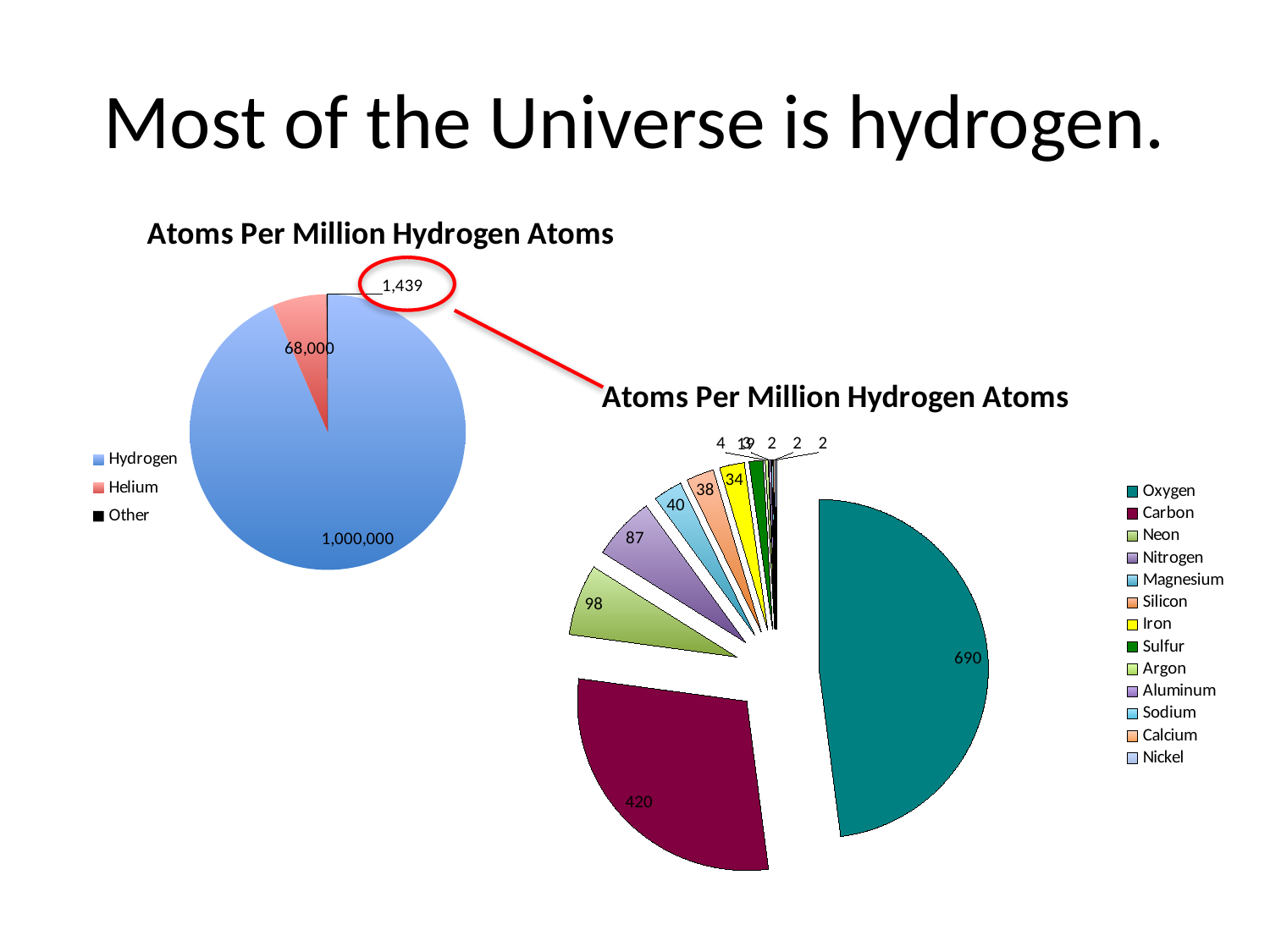
On the right pie chart, what is the value shown for Oxygen? 690 On the left pie chart, what is the difference between the Hydrogen value and the Helium value? 932,000 On the left pie chart, what is the value shown for the Other slice? 1,439 On the left chart, what kind of chart is used? pie chart On the right pie chart, which element has the largest slice? Oxygen On the left pie chart, how many categories does the legend list? 3 On the right pie chart, how many elements does the legend list? 13 On the left pie chart, what is the value shown for Hydrogen? 1,000,000 On the left pie chart, what is the value shown for Helium? 68,000 On the right pie chart, what is the value shown for Neon? 98 On the right pie chart, what is the value shown for Carbon? 420 On the right pie chart, what is the difference between the Oxygen value and the Carbon value? 270